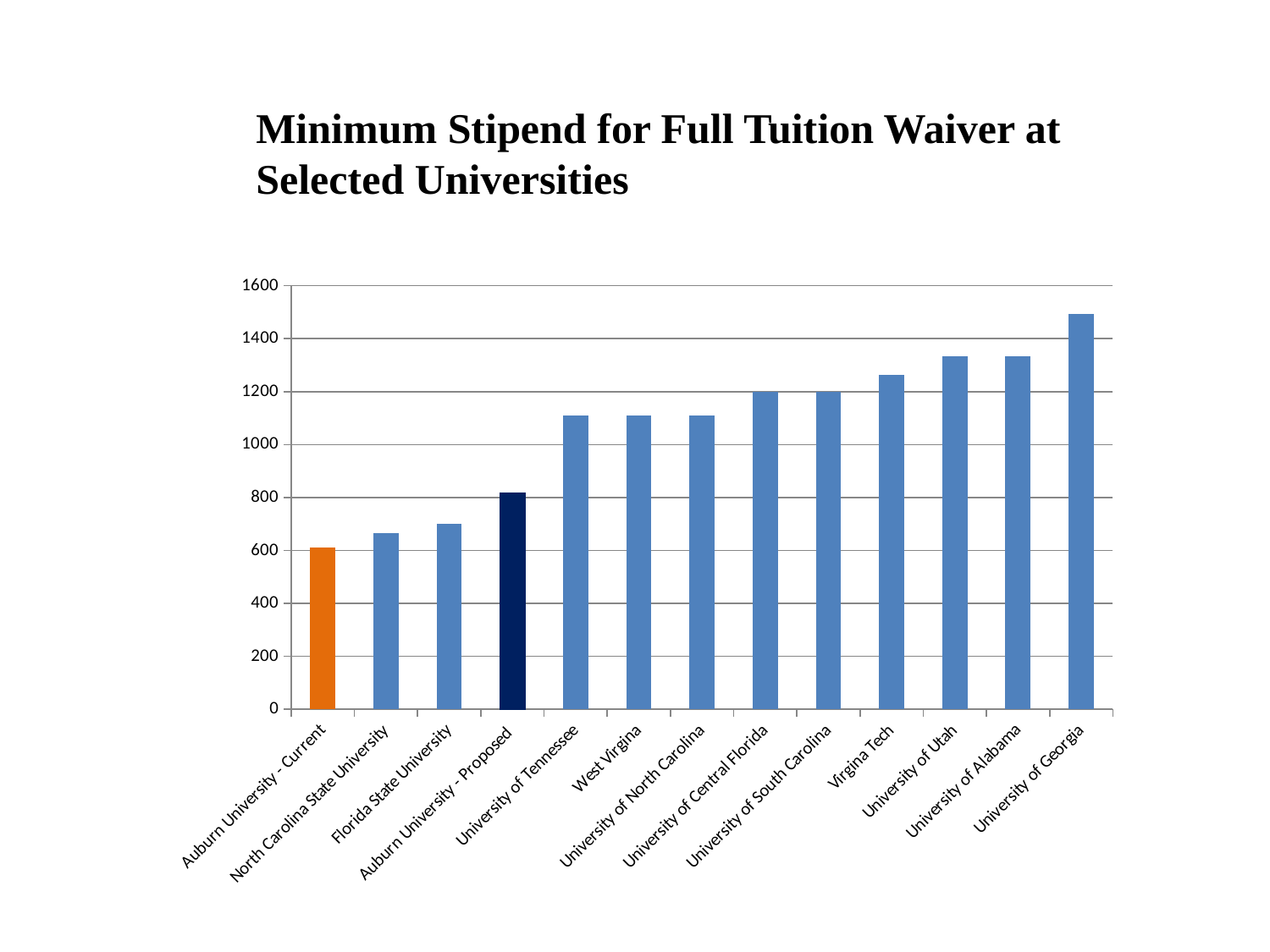
Is the value for Virgina Tech greater or less than 1200? greater Is the value for Auburn University - Current greater or less than 800? less Which is larger, the value for Auburn University - Proposed or the value for Florida State University? Auburn University - Proposed Which university has the highest minimum stipend in the chart? University of Georgia Is the value for University of Georgia greater or less than 1400? greater Which category has the lowest value in the chart? Auburn University - Current Do the values generally rise or fall moving from left to right along the x axis? Rise What colour is the bar for Auburn University - Current? Orange How many universities (bars) are shown in the chart? 13 What kind of chart is shown on the slide? Bar chart